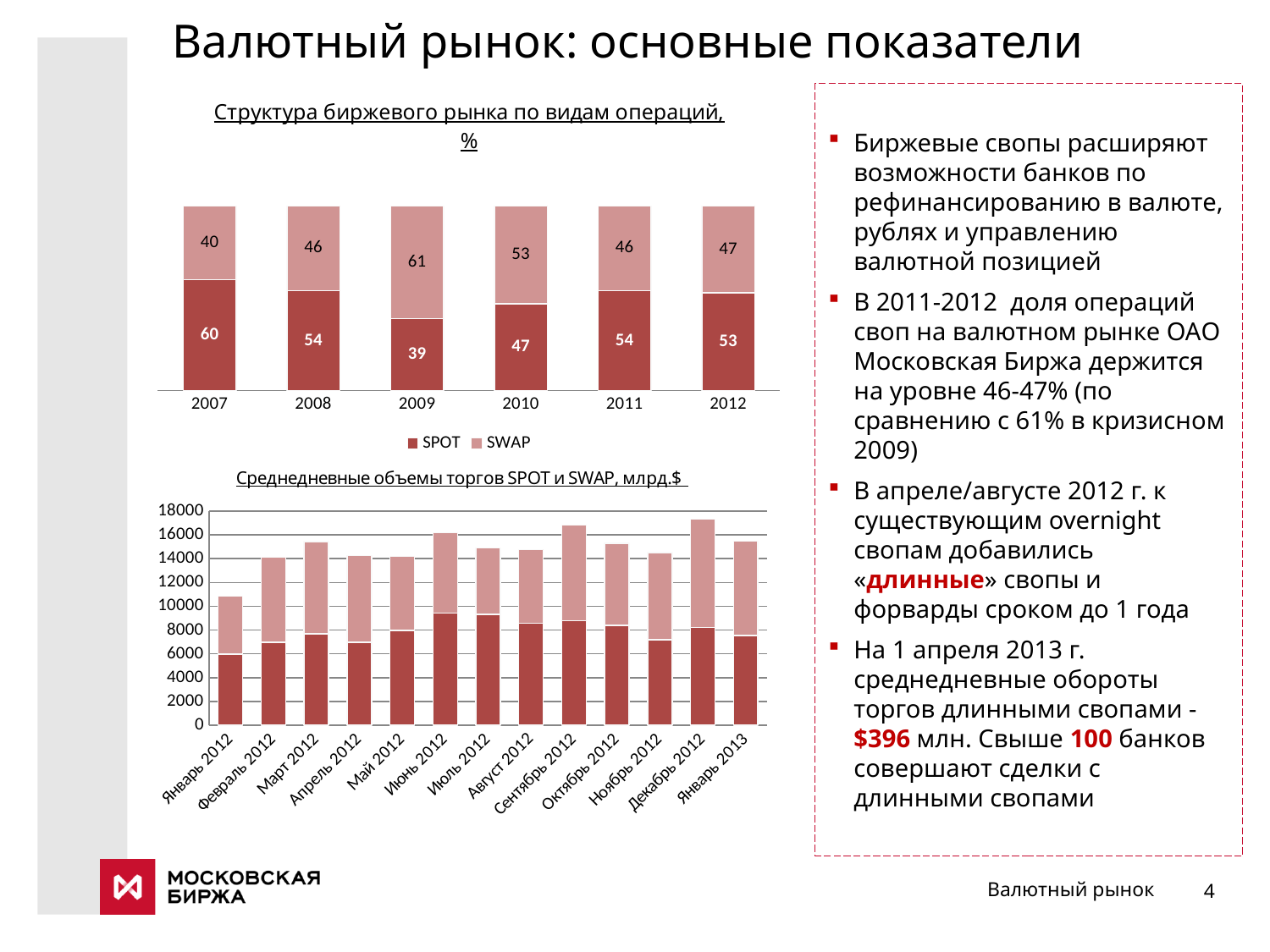
How many years are shown in the top chart 'Структура биржевого рынка по видам операций, %'? 6 In the top chart 'Структура биржевого рынка по видам операций, %', which year has the lowest SPOT share? 2009 How many series does the legend of the top chart list? 2 What kind of chart is the bottom chart 'Среднедневные объемы торгов SPOT и SWAP, млрд.$'? Stacked bar chart What are the two legend entries of the top chart? SPOT and SWAP In the bottom chart 'Среднедневные объемы торгов SPOT и SWAP, млрд.$', is the total bar height for Январь 2012 greater or less than 12000? less In the top chart 'Структура биржевого рынка по видам операций, %', what is the SPOT value for 2009? 39 In the top chart 'Структура биржевого рынка по видам операций, %', what is the difference between the SPOT and SWAP values for 2007? 20 In the bottom chart 'Среднедневные объемы торгов SPOT и SWAP, млрд.$', which month has the lowest total bar? Январь 2012 In the top chart 'Структура биржевого рынка по видам операций, %', which is larger for 2008, SPOT or SWAP? SPOT In the top chart 'Структура биржевого рынка по видам операций, %', which year has the highest SWAP share? 2009 In the top chart 'Структура биржевого рынка по видам операций, %', what is the SWAP value for 2010? 53